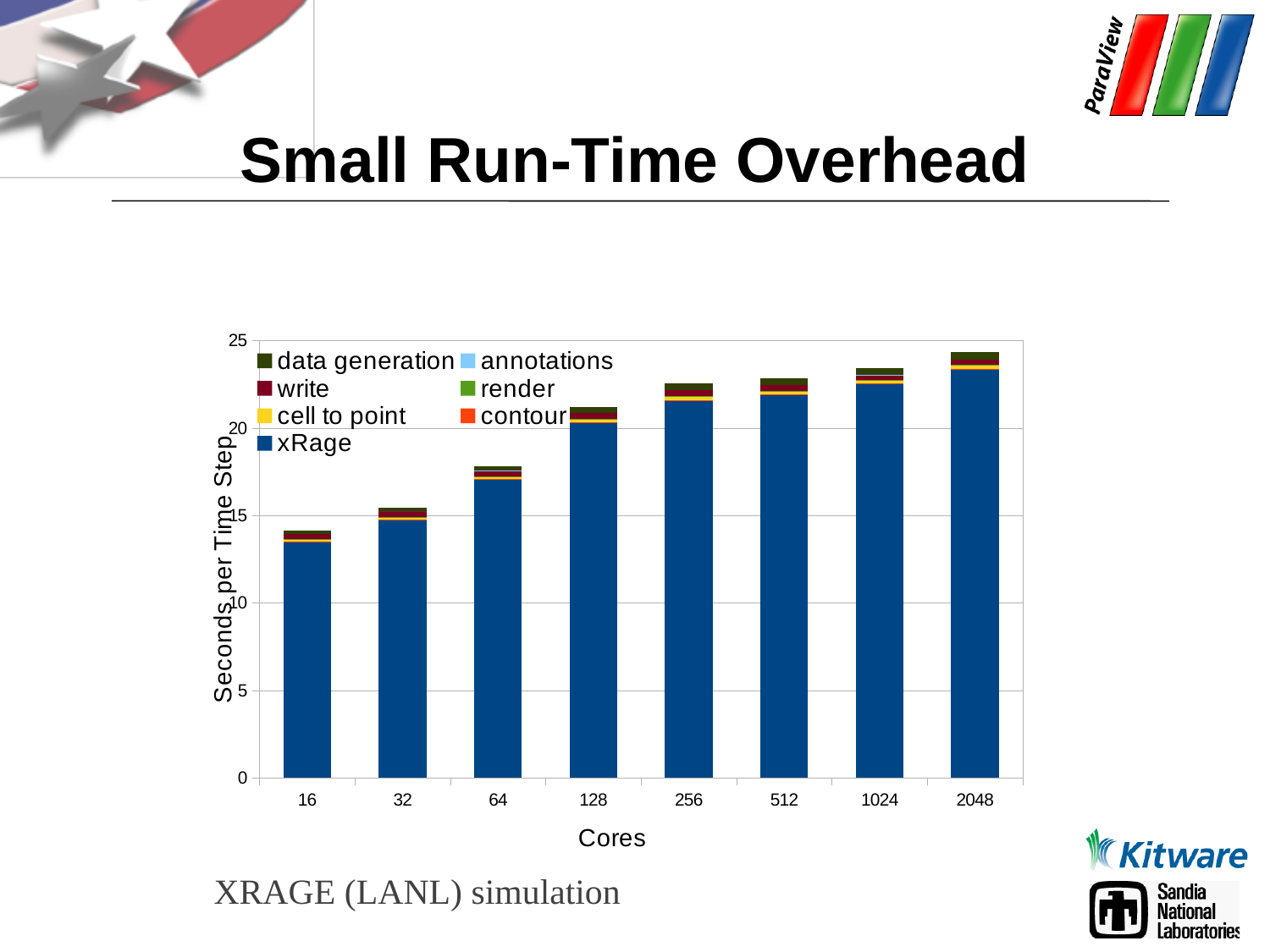
How many core counts are shown along the x axis of the chart? 8 Do the total seconds per time step rise or fall as the number of cores increases? rise What kind of chart is shown on the slide? stacked bar chart What is the label of the y axis of the chart? Seconds per Time Step Which core count has the shortest stacked bar? 16 Is the total bar height for 128 cores greater or less than 20? greater Is the total bar height for 64 cores greater or less than 20? less Which core count has the tallest stacked bar? 2048 Which is larger, the total bar for 32 cores or the total bar for 256 cores? 256 cores Is the total bar height for 16 cores greater or less than 15? less How many series does the chart's legend list? 7